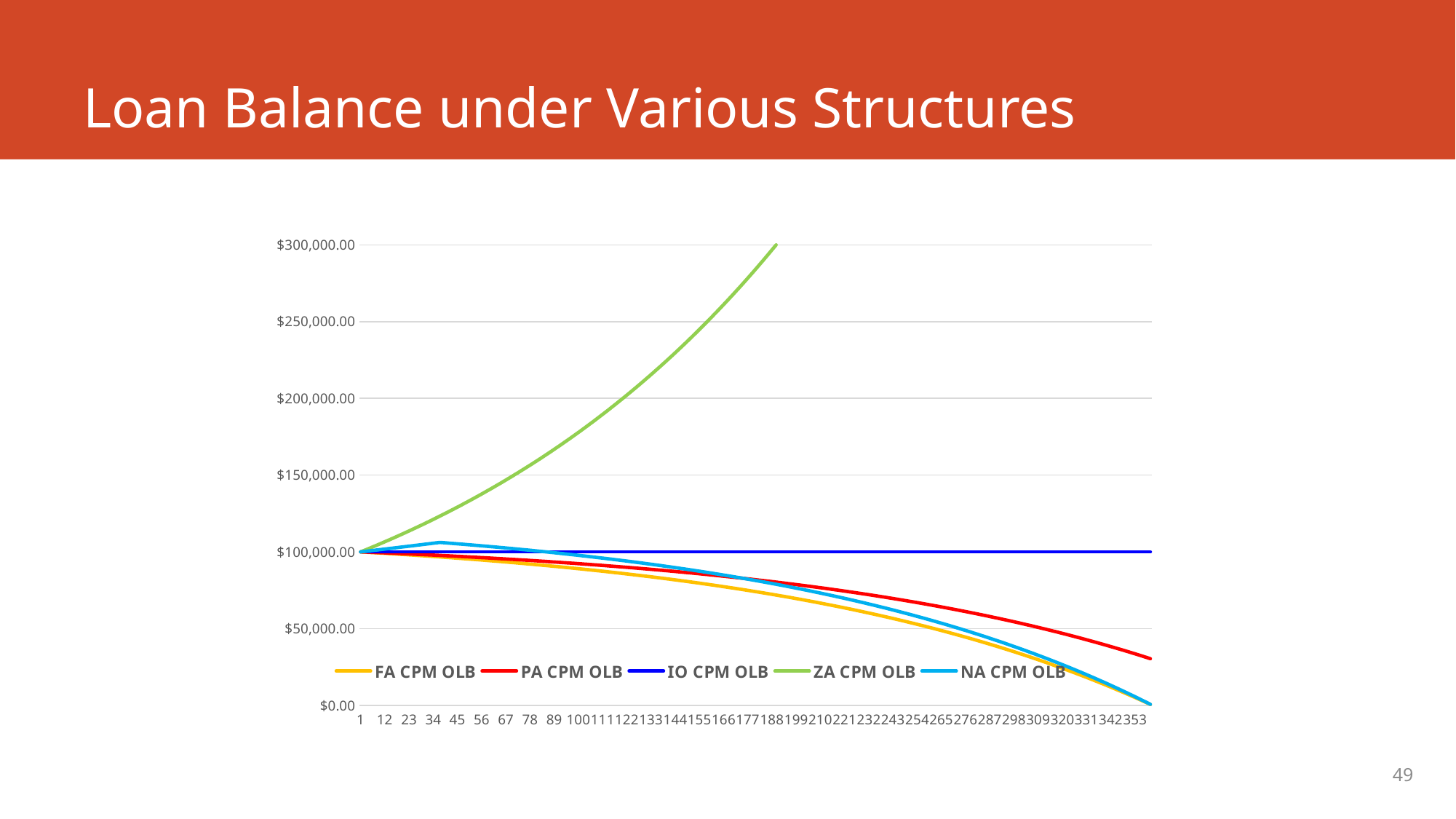
Is the value for ZA CPM OLB at period 144 greater or less than $200,000.00? greater Which colour is used for the ZA CPM OLB series? green Is the value for PA CPM OLB at period 353 greater or less than $50,000.00? less What is the value of the IO CPM OLB series across the whole period? $100,000.00 What is the title of the chart? Loan Balance under Various Structures At period 353, which is larger: PA CPM OLB or FA CPM OLB? PA CPM OLB What kind of chart is shown on the slide? line chart Which series has the highest value at period 188? ZA CPM OLB Does the ZA CPM OLB line rise or fall along the x axis? rise How many series does the legend list? 5 Does the FA CPM OLB line rise or fall along the x axis? fall